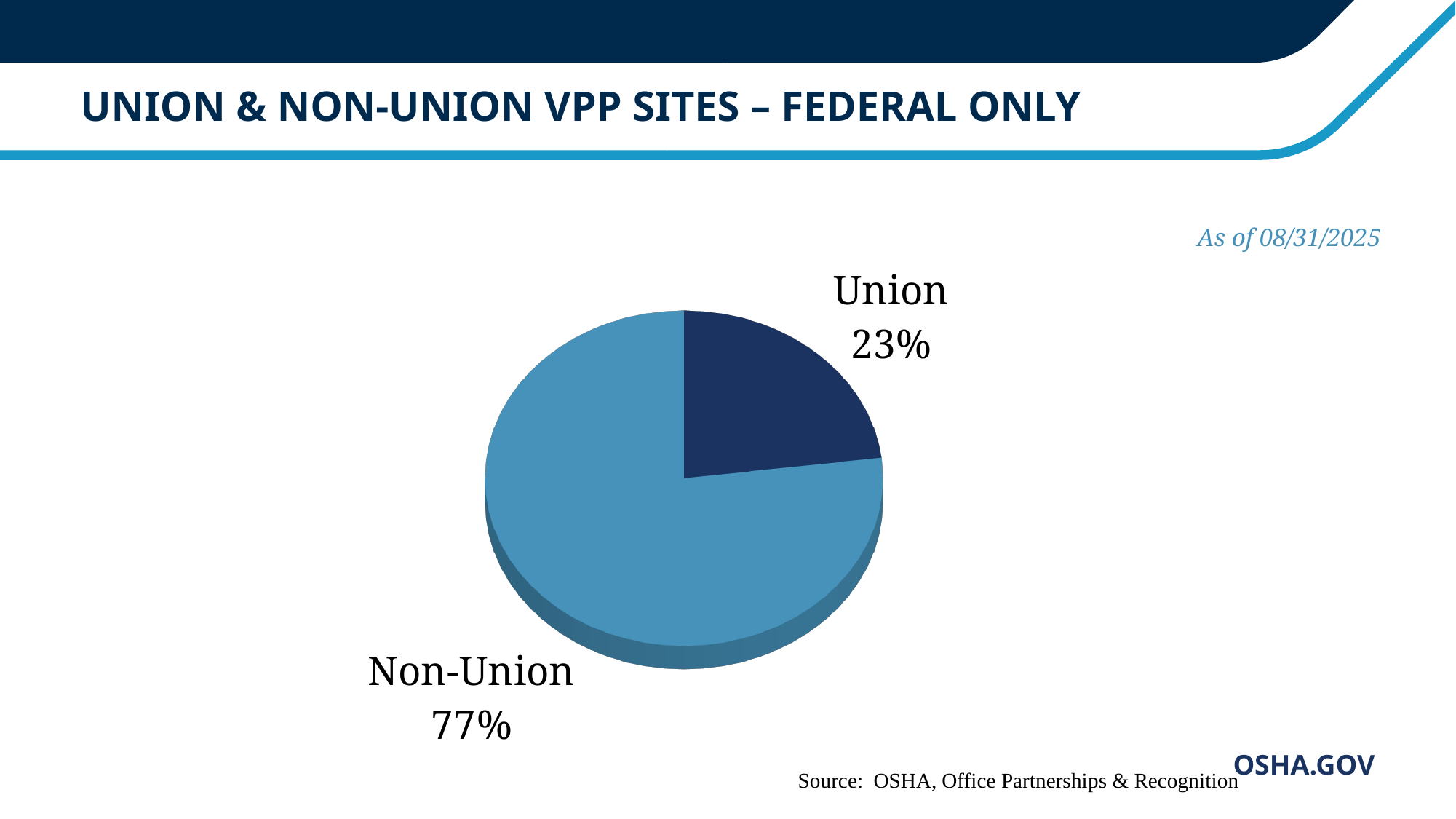
What date is the chart data stated to be as of? 08/31/2025 Which slice is the largest? Non-Union What share of the pie is Union? 23% What share of the pie is Non-Union? 77% What kind of chart is shown on the slide? pie chart What is the title of the slide containing the chart? UNION & NON-UNION VPP SITES – FEDERAL ONLY Which is larger, the Union slice or the Non-Union slice? Non-Union How many slices does the pie chart have? 2 Which slice is the smallest? Union What is the difference in percentage points between the Non-Union and Union slices? 54